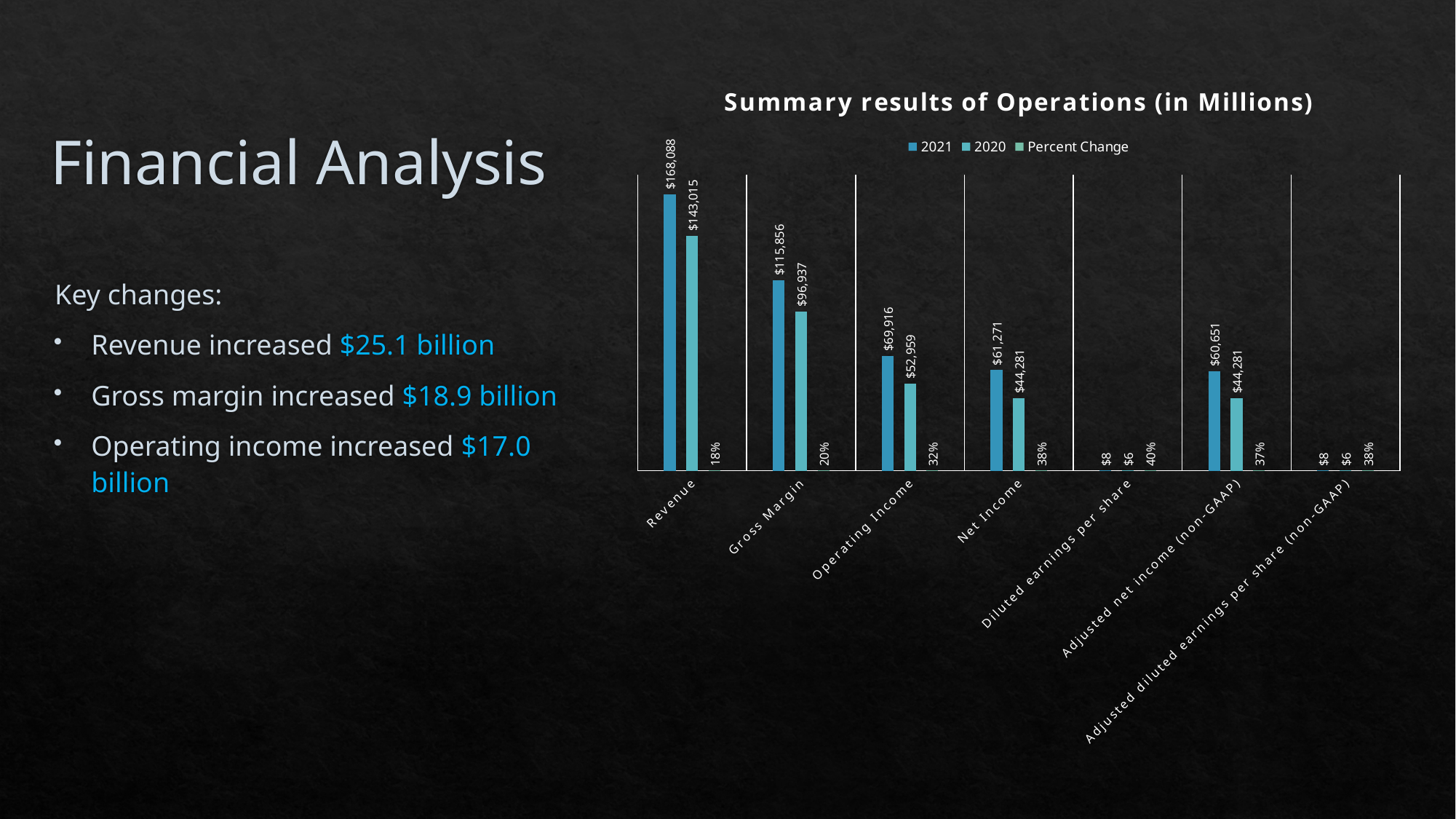
Which category has the lowest Percent Change? Revenue Which category has the highest 2021 value? Revenue How many categories are shown on the x axis of the chart? 7 Which is larger, the 2021 value for Net Income or the 2021 value for Adjusted net income (non-GAAP)? Net Income How many series does the chart legend list? 3 What is the difference between the 2021 and 2020 values for Operating Income? $16,957 What is the Percent Change for Diluted earnings per share? 40% What kind of chart is shown on the slide? Bar chart What is the 2021 value for Revenue? $168,088 What is the difference between the 2021 and 2020 values for Revenue? $25,073 What is the 2020 value for Gross Margin? $96,937 What is the 2021 value for Adjusted net income (non-GAAP)? $60,651